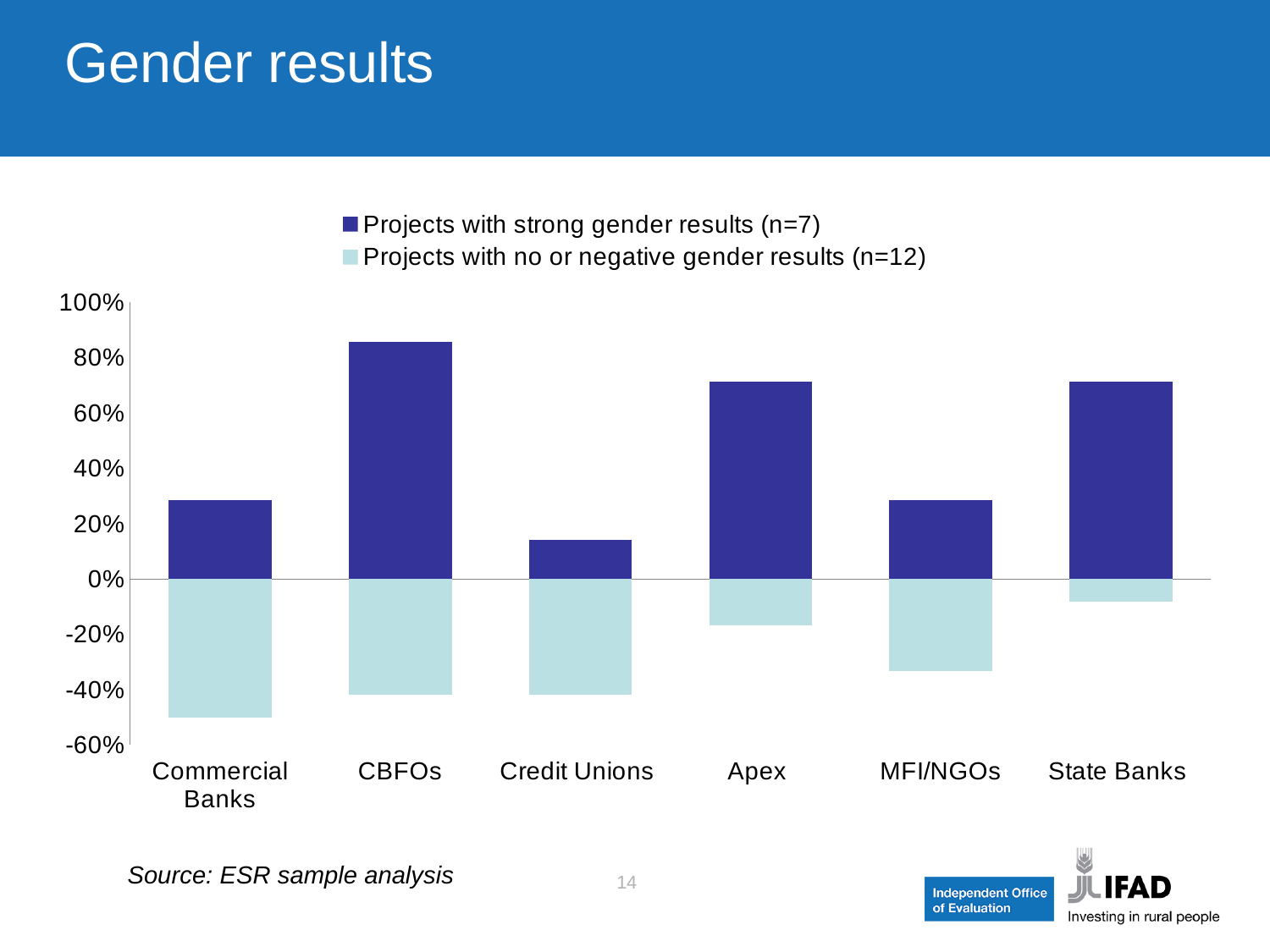
How many categories are shown on the x axis of the chart? 6 Is the value for CBFOs in 'Projects with strong gender results (n=7)' greater or less than 80%? greater Is the value for Apex in 'Projects with strong gender results (n=7)' greater or less than 60%? greater Is the value for Credit Unions in 'Projects with strong gender results (n=7)' greater or less than 20%? less Which category has the highest value for 'Projects with strong gender results (n=7)'? CBFOs What kind of chart is shown on the slide? bar chart Which category has the lowest value for 'Projects with strong gender results (n=7)'? Credit Unions Which category has the most negative value for 'Projects with no or negative gender results (n=12)'? Commercial Banks Which category has the least negative value for 'Projects with no or negative gender results (n=12)'? State Banks How many series does the chart's legend list? 2 Which series is shown in dark blue in the chart? Projects with strong gender results (n=7)